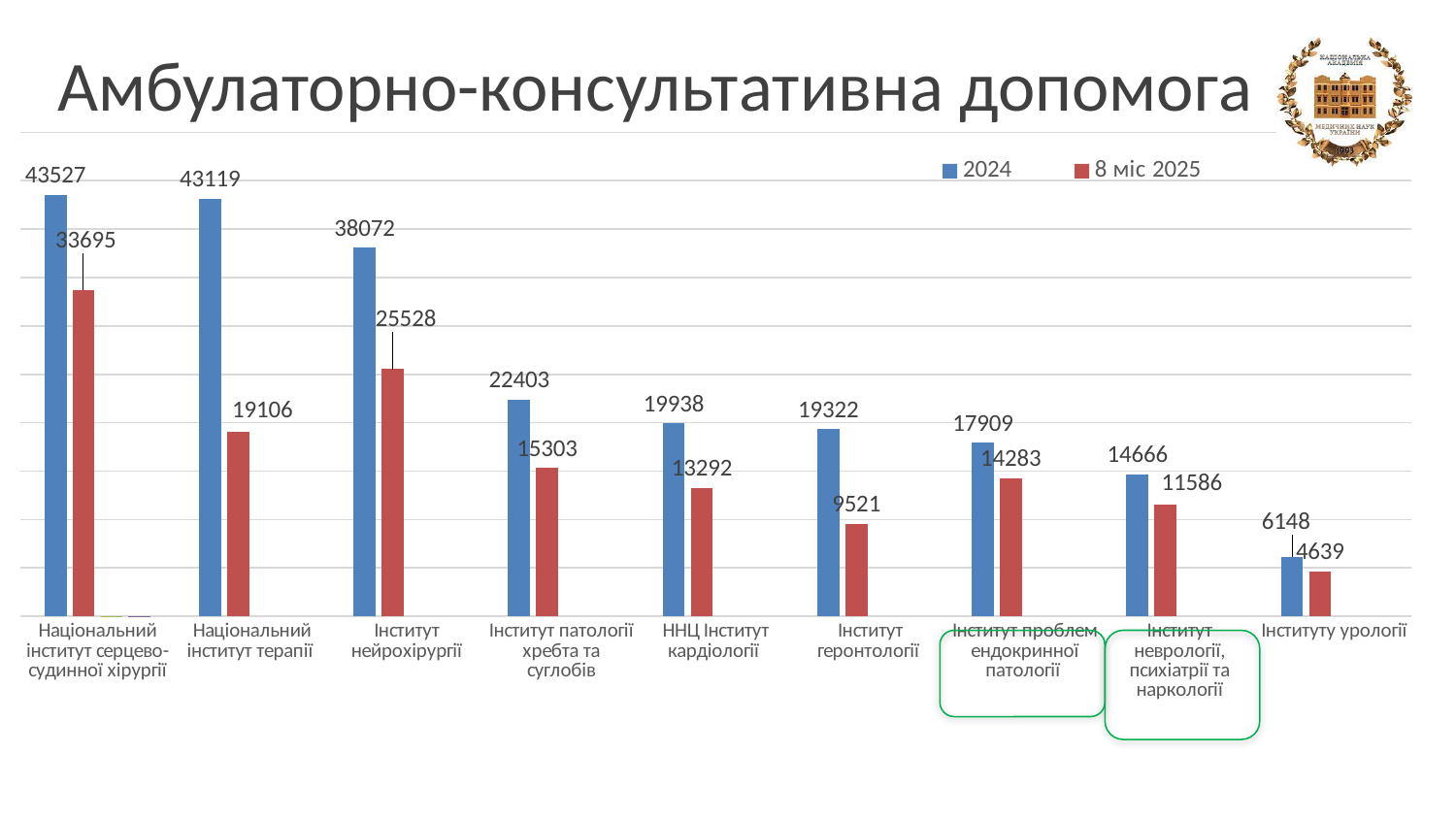
Which category has the lowest 8 міс 2025 value? Інституту урології What is the 2024 value for Інститут нейрохірургії? 38072 How many series does the legend list? 2 How many categories are shown on the x axis? 9 Which is larger: the 8 міс 2025 value for Інститут нейрохірургії or the 8 міс 2025 value for Національний інститут терапії? Інститут нейрохірургії What kind of chart is shown on the slide? Bar chart What is the 8 міс 2025 value for Інститут проблем ендокринної патології? 14283 What is the difference between the 2024 values for Інститут патології хребта та суглобів and ННЦ Інститут кардіології? 2465 What is the difference between the 2024 and 8 міс 2025 values for Національний інститут терапії? 24013 Which category has the highest 2024 value? Національний інститут серцево-судинної хірургії What is the title of the slide? Амбулаторно-консультативна допомога What is the 8 міс 2025 value for Інститут геронтології? 9521